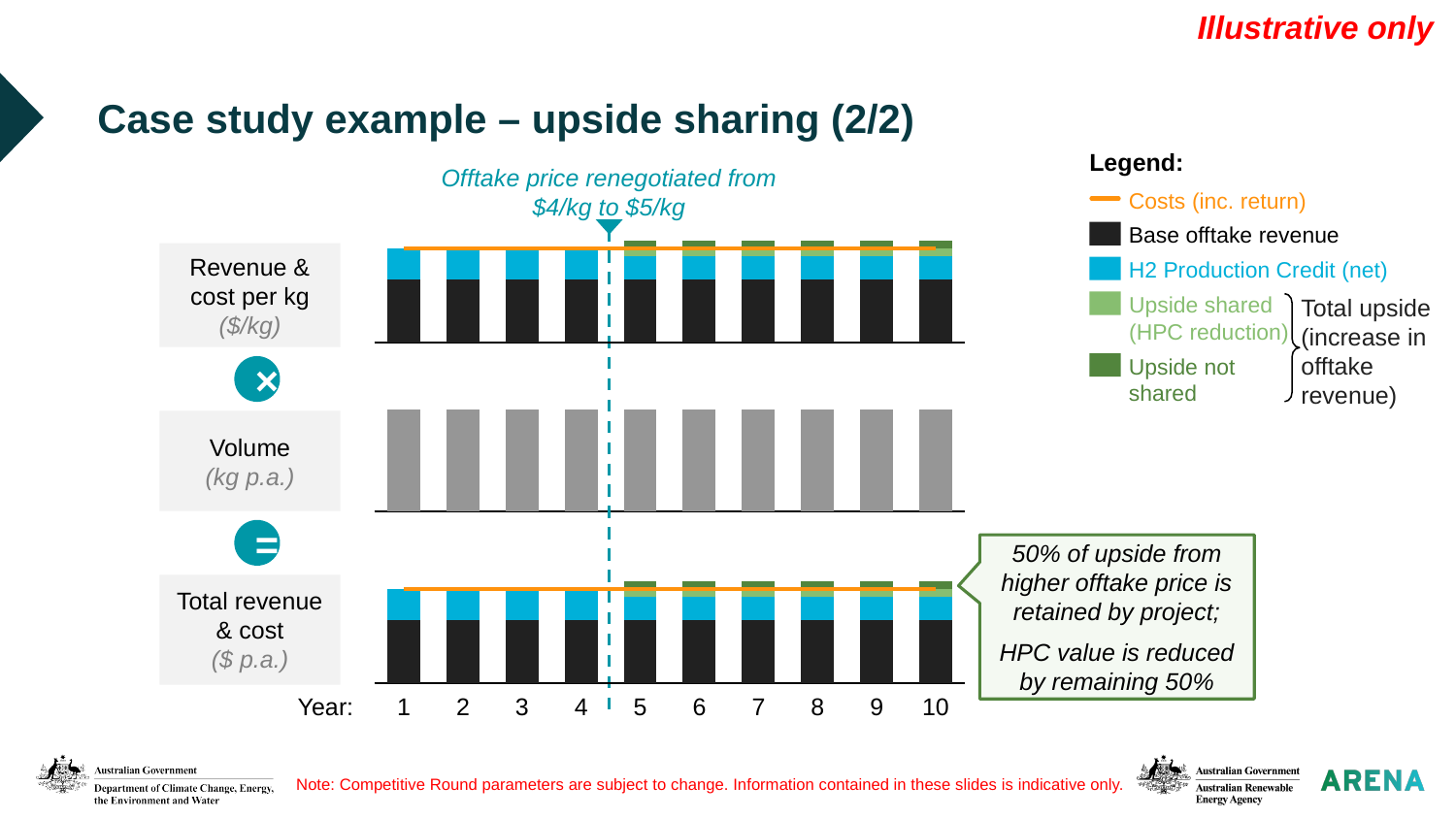
How many years are shown on the x axis of the charts? 10 How many bars are plotted in the 'Volume (kg p.a.)' chart? 10 According to the annotation above the top chart, the offtake price is renegotiated from what to what? $4/kg to $5/kg In the 'Revenue & cost per kg ($/kg)' chart, from which year do the green upside segments first appear on top of the bars? Year 5 In the 'Revenue & cost per kg ($/kg)' chart, do the bars for years 1 to 4 rise, fall or stay flat? stay flat What kind of chart is the 'Volume (kg p.a.)' chart? bar chart In the 'Total revenue & cost ($ p.a.)' chart, is the bar for year 5 taller or shorter than the bar for year 4? taller In the 'Volume (kg p.a.)' chart, do the bars rise, fall or stay flat from year 1 to year 10? stay flat What kind of chart is the 'Total revenue & cost ($ p.a.)' chart? combination bar and line chart How many entries does the legend list? 5 Which colour represents 'Costs (inc. return)' in the legend? orange